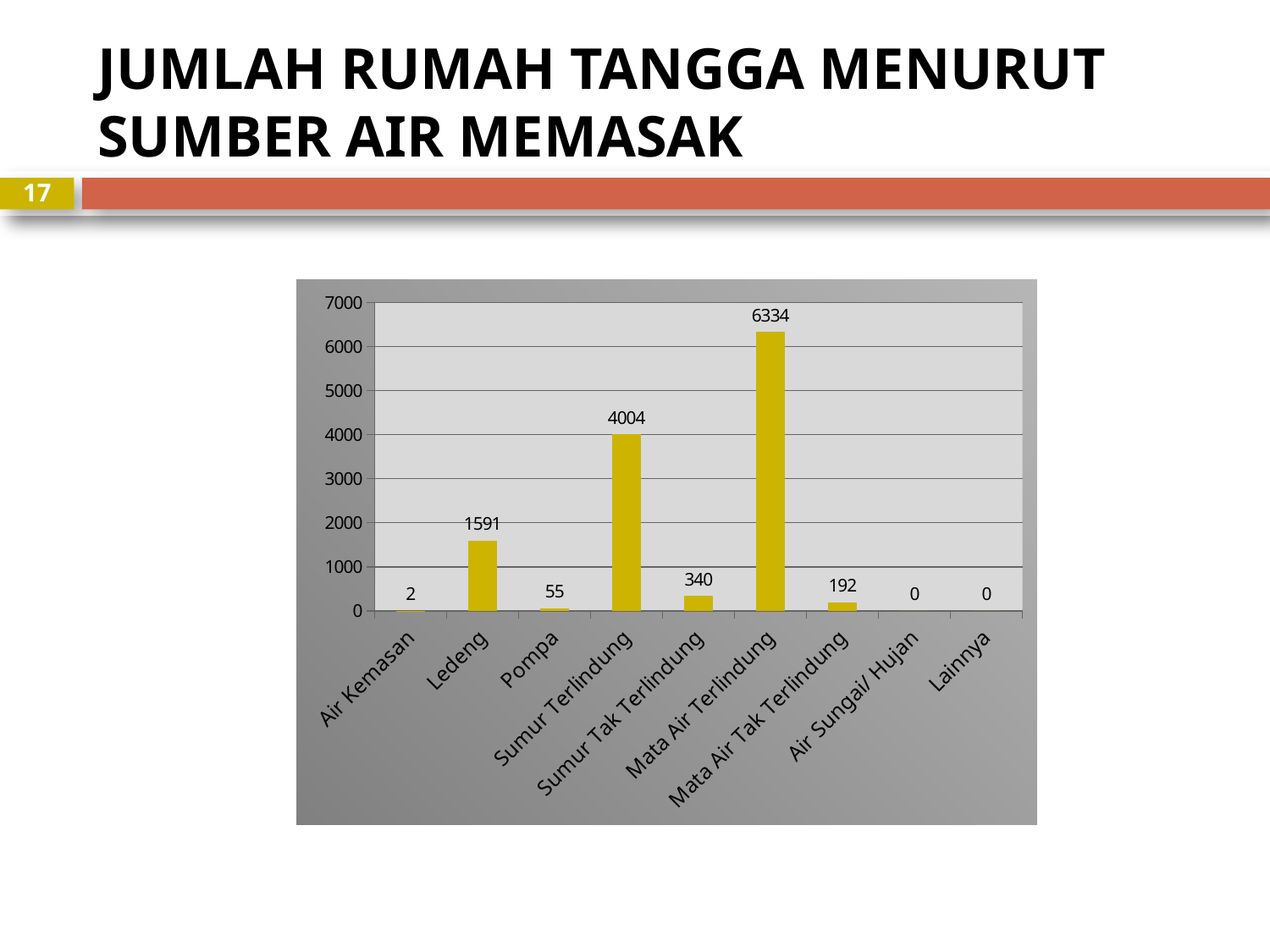
Which category has the highest value? Mata Air Terlindung How many categories are shown on the x axis? 9 What is the difference between the values for Mata Air Terlindung and Sumur Terlindung? 2330 Which is larger, the value for Ledeng or the value for Mata Air Tak Terlindung? Ledeng How many categories have a value of 0? 2 What is the value for Sumur Terlindung? 4004 What is the value for Ledeng? 1591 What is the value for Mata Air Terlindung? 6334 Is the value for Sumur Terlindung greater or less than 3000? greater What kind of chart is shown on the slide? bar chart What is the value for Sumur Tak Terlindung? 340 What is the title of the slide containing the chart? JUMLAH RUMAH TANGGA MENURUT SUMBER AIR MEMASAK